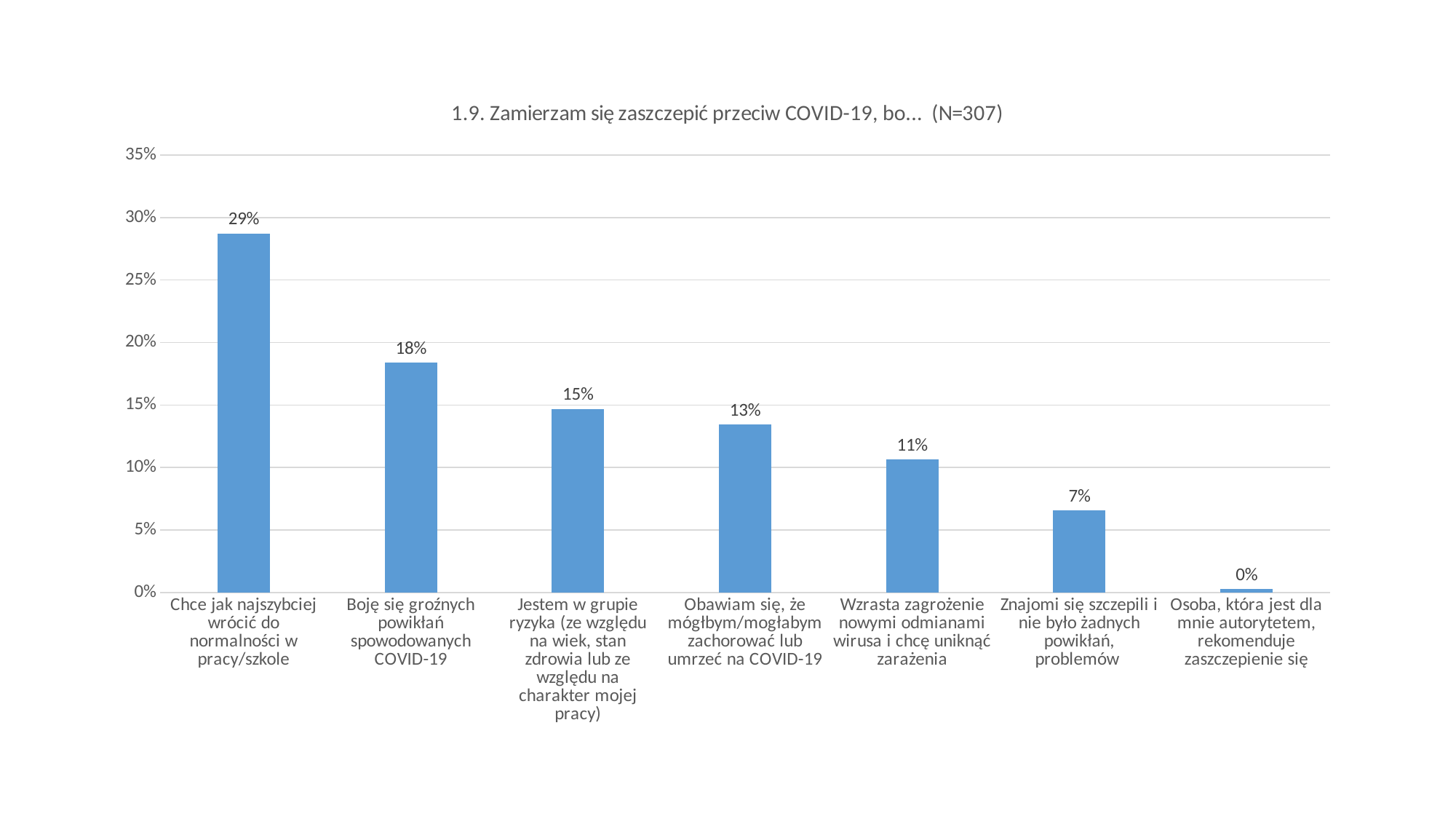
Which category has the lowest value? Osoba, która jest dla mnie autorytetem, rekomenduje zaszczepienie się What is the difference between the values for "Chce jak najszybciej wrócić do normalności w pracy/szkole" and "Boję się groźnych powikłań spowodowanych COVID-19"? 11% What is the value for "Znajomi się szczepili i nie było żadnych powikłań, problemów"? 7% Which category has the highest value? Chce jak najszybciej wrócić do normalności w pracy/szkole What is the value for "Chce jak najszybciej wrócić do normalności w pracy/szkole"? 29% What is the value for "Boję się groźnych powikłań spowodowanych COVID-19"? 18% What is the sample size (N) given in the chart title? 307 What kind of chart is shown on the slide? bar chart Is the value for "Jestem w grupie ryzyka" greater or less than 10%? greater How many categories are shown on the chart? 7 What is the value for "Osoba, która jest dla mnie autorytetem, rekomenduje zaszczepienie się"? 0% Which is larger: the value for "Obawiam się, że mógłbym/mogłabym zachorować lub umrzeć na COVID-19" or the value for "Wzrasta zagrożenie nowymi odmianami wirusa i chcę uniknąć zarażenia"? Obawiam się, że mógłbym/mogłabym zachorować lub umrzeć na COVID-19